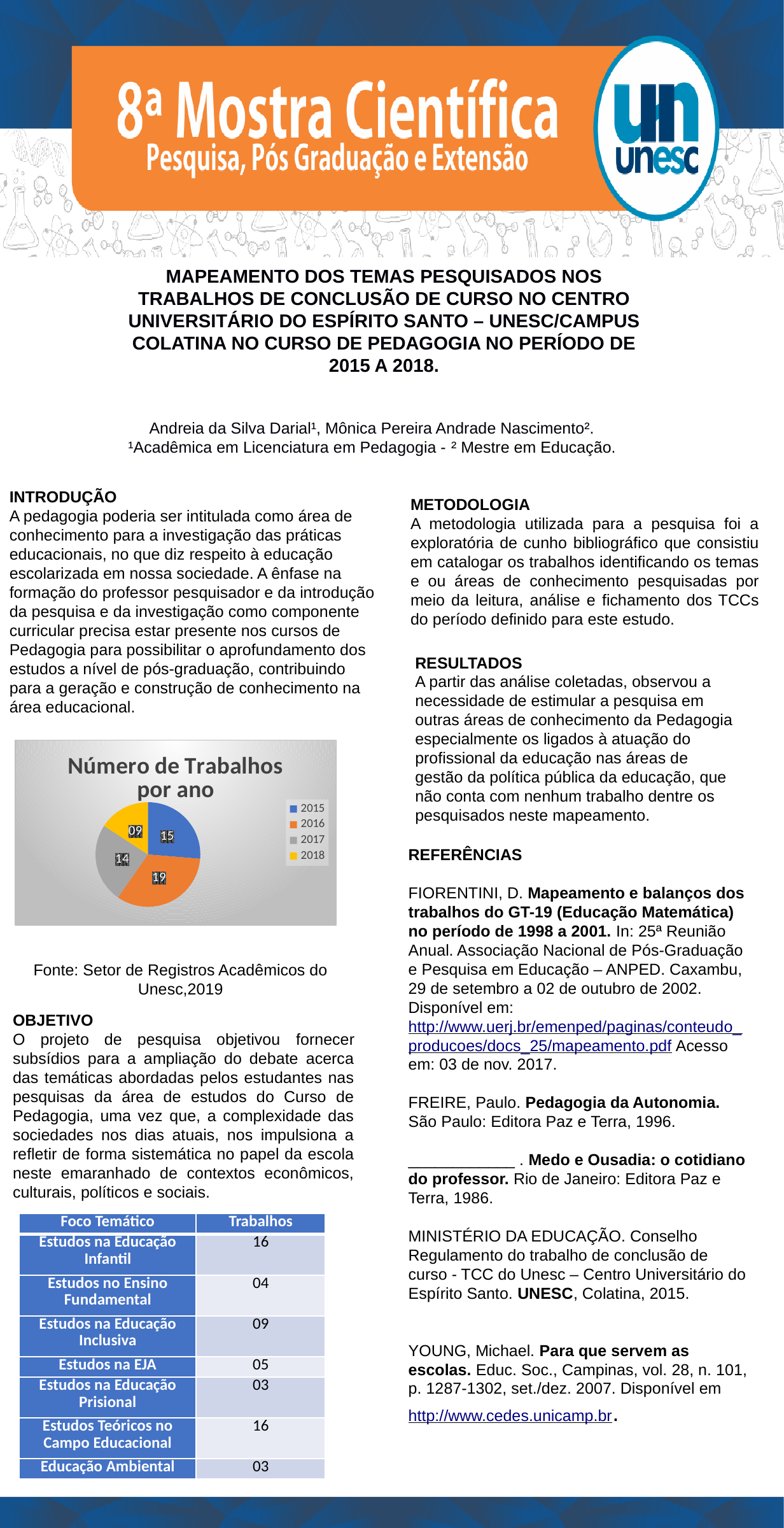
How many entries does the chart legend list? 4 What is the value shown for 2018 in the pie chart? 09 What is the value shown for 2015 in the pie chart? 15 What is the value shown for 2017 in the pie chart? 14 What is the value shown for 2016 in the pie chart? 19 Which year has the smallest slice in the pie chart? 2018 How many slices does the pie chart have? 4 What is the difference between the values for 2016 and 2018 in the pie chart? 10 What type of chart is shown on the slide? pie chart Which colour represents 2017 in the pie chart? grey Which year has the largest slice in the pie chart? 2016 What is the title of the chart? Número de Trabalhos por ano